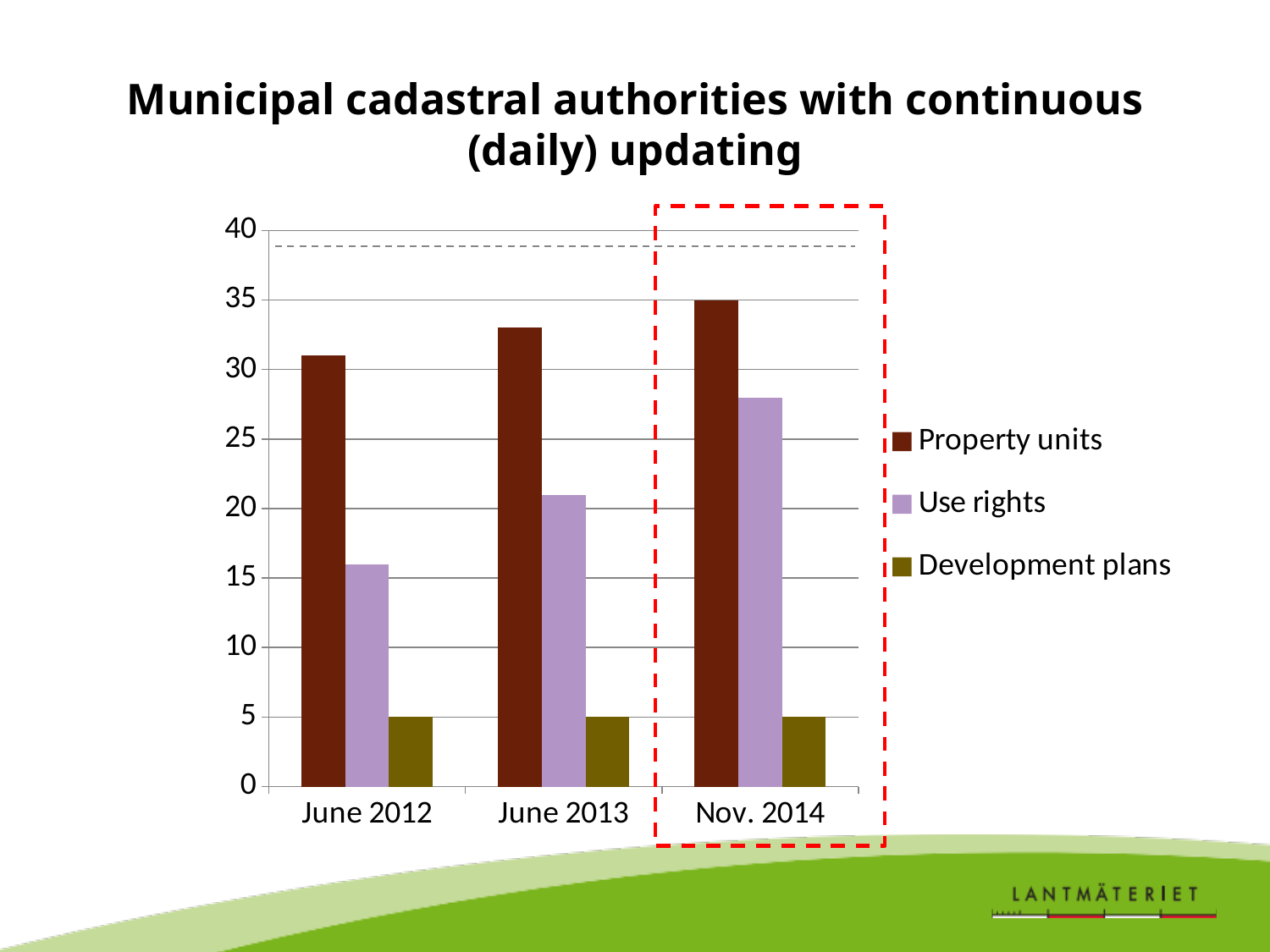
Is the value for Property units in June 2013 greater or less than 30? greater Do the Use rights values rise or fall from June 2012 to Nov. 2014? rise How many series does the legend list? 3 What kind of chart is shown on the slide? bar chart What is the value for Property units in Nov. 2014? 35 Which category has the lowest value for Property units? June 2012 Which is larger in June 2013: Property units or Use rights? Property units Which category has the highest value for Use rights? Nov. 2014 Is the value for Use rights in Nov. 2014 greater or less than 25? greater How many categories are shown on the x axis? 3 What is the value for Development plans in June 2012? 5 Is the value for Use rights in June 2012 greater or less than 20? less